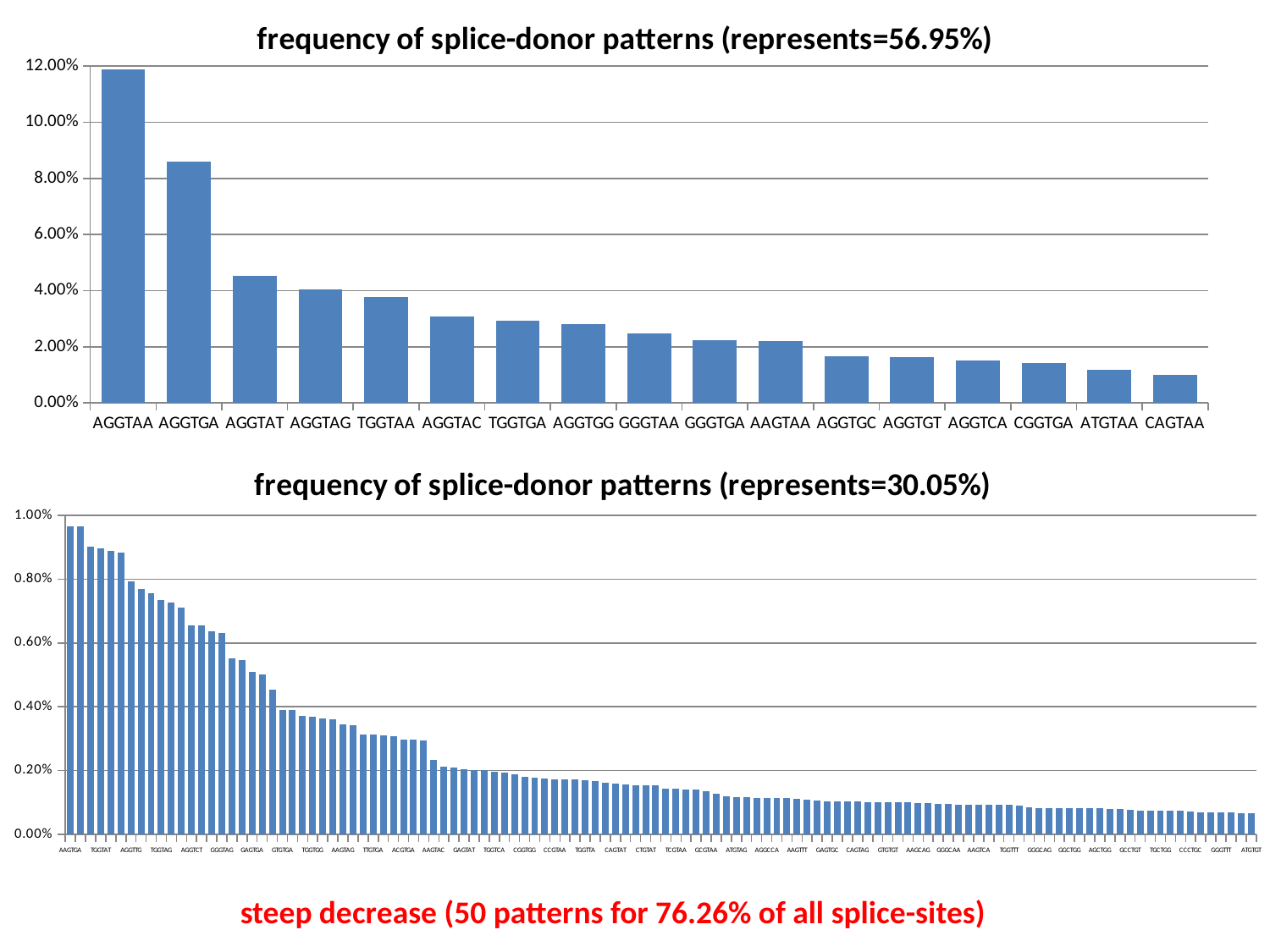
In the top chart (represents=56.95%), is the value for AGGTAA greater or less than 10.00%? greater How many splice-donor patterns are shown in the top chart (represents=56.95%)? 17 In the top chart (represents=56.95%), is the value for CAGTAA greater or less than 2.00%? less In the bottom chart (represents=30.05%), do the values rise or fall from left to right? fall What is the title of the bottom chart? frequency of splice-donor patterns (represents=30.05%) In the top chart (represents=56.95%), is the value for TGGTAA greater or less than 4.00%? less In the top chart (represents=56.95%), which splice-donor pattern has the highest frequency? AGGTAA What is the highest value shown on the y axis of the bottom chart (represents=30.05%)? 1.00% In the top chart (represents=56.95%), which has a higher frequency, AGGTAT or AGGTAC? AGGTAT In the top chart (represents=56.95%), which splice-donor pattern has the lowest frequency? CAGTAA What kind of chart is the top chart (represents=56.95%)? bar chart